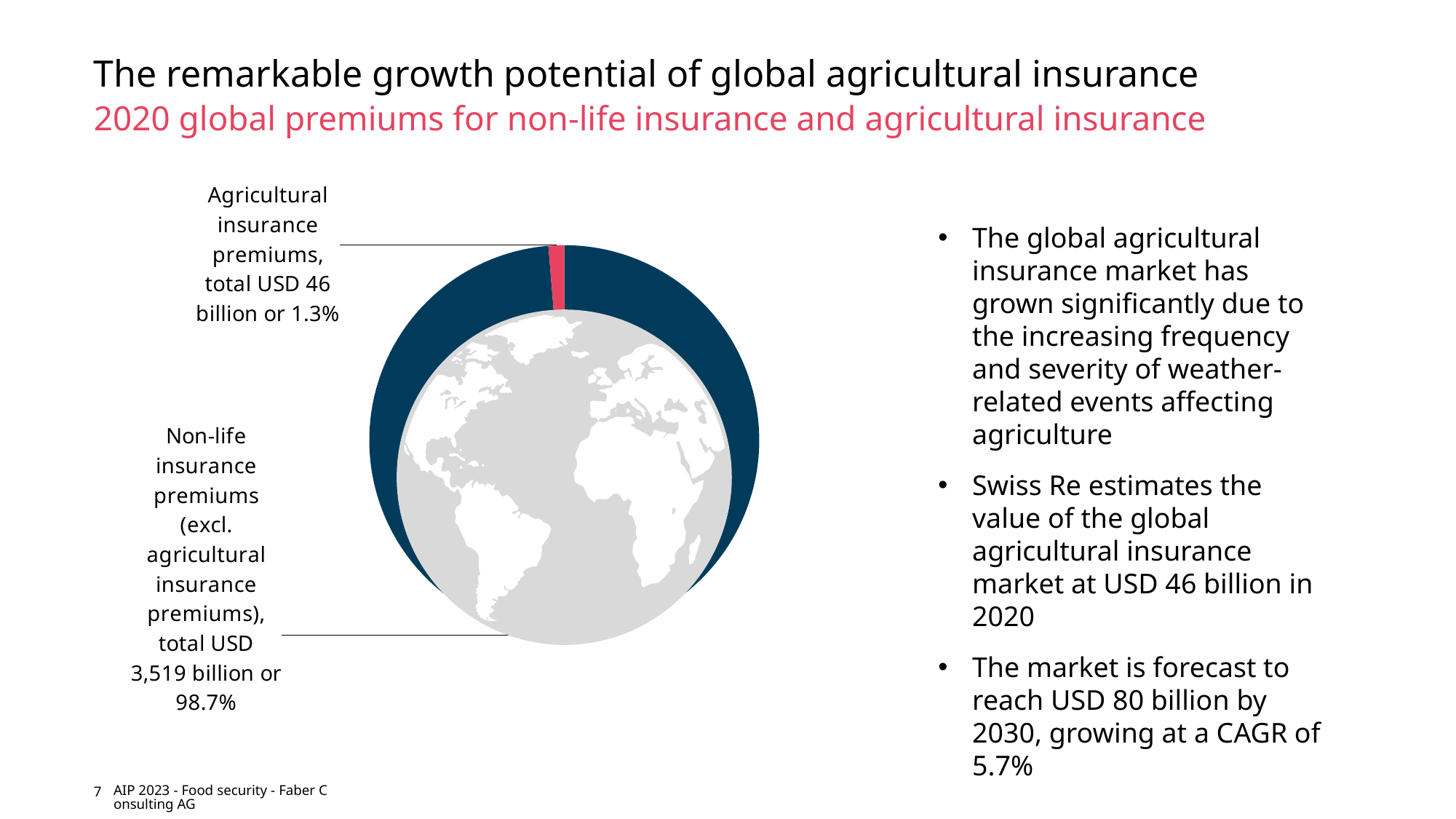
Which slice of the pie chart is the largest? Non-life insurance premiums (excl. agricultural insurance premiums) What is the difference in USD billion between non-life insurance premiums (excl. agricultural) and agricultural insurance premiums? USD 3,473 billion What is the total value of non-life insurance premiums (excl. agricultural insurance premiums) shown in the pie chart? USD 3,519 billion What kind of chart is shown on the slide? Doughnut chart What share of the pie do non-life insurance premiums (excl. agricultural insurance premiums) represent? 98.7% What colour is the agricultural insurance premiums slice in the pie chart? Red What share of the pie do agricultural insurance premiums represent? 1.3% How many slices does the pie chart have? 2 What is the total value of agricultural insurance premiums shown in the pie chart? USD 46 billion What year do the global premiums in the pie chart refer to? 2020 Which slice of the pie chart is the smallest? Agricultural insurance premiums Which is larger: agricultural insurance premiums or non-life insurance premiums (excl. agricultural)? Non-life insurance premiums (excl. agricultural)